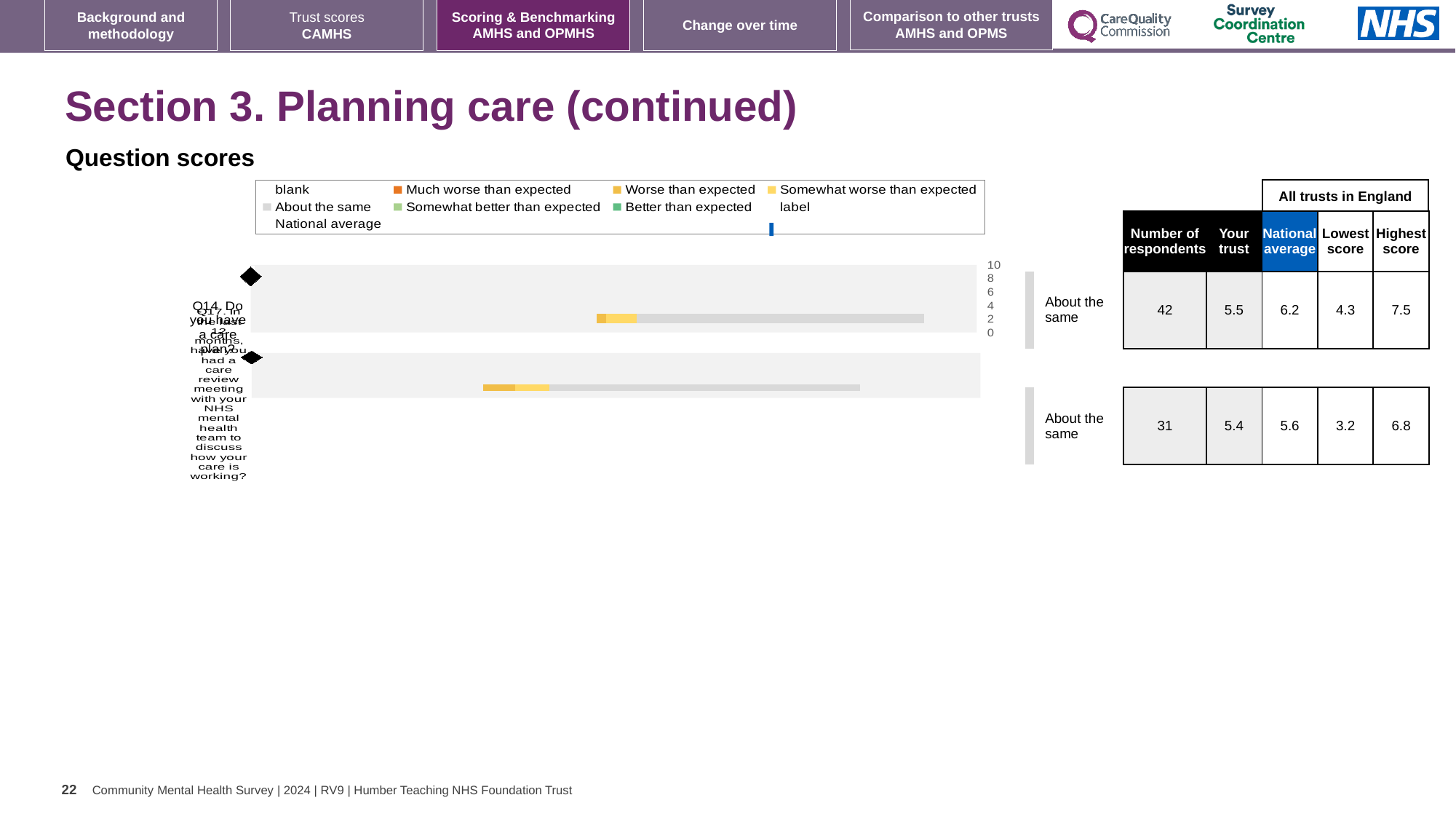
Which is larger for Q14: the 'Your trust' score or the national average? National average What is the highest score among all trusts in England shown for Q17? 6.8 What is the lowest score among all trusts in England shown for Q17? 3.2 How many questions are plotted in the question scores chart? 2 What is the maximum value shown on the chart's score axis? 10 What is the number of respondents shown for Q14 (Do you have a care plan?)? 42 Which question has more respondents, Q14 or Q17? Q14 What kind of chart is used to show the question scores on this slide? bar chart What benchmark category is shown next to the bar for Q17? About the same What is the national average score shown for Q14? 6.2 What is the difference between the highest score and the lowest score shown for Q14? 3.2 What is the 'Your trust' score shown for Q14? 5.5